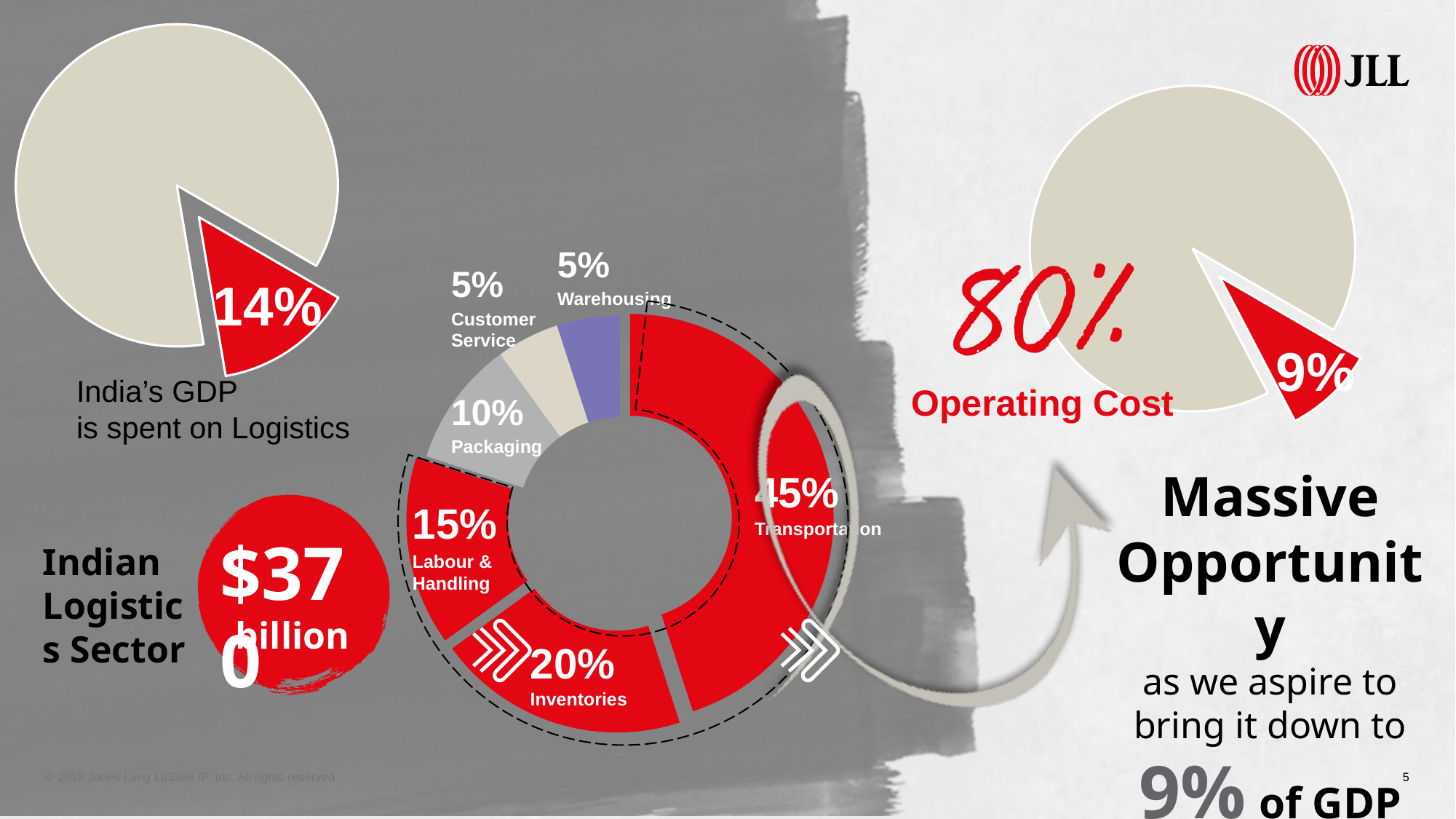
In the centre donut chart, what is the value for Labour & Handling? 15% What type of chart is the chart in the centre of the slide? Donut chart In the pie chart at the top right of the slide, what value is shown on the red slice? 9% In the centre donut chart, what is the combined share of the three red segments (Transportation, Inventories, Labour & Handling)? 80% In the centre donut chart, which category has the largest share? Transportation In the centre donut chart, what is the difference between Transportation and Inventories? 25% In the centre donut chart, which is larger, Inventories or Labour & Handling? Inventories In the pie chart at the top left of the slide, what share of India's GDP is spent on Logistics? 14% In the centre donut chart, what is the value for Inventories? 20% In the centre donut chart, how many categories are shown? 6 In the centre donut chart, what is the value for Transportation? 45% In the centre donut chart, what is the value for Packaging? 10%